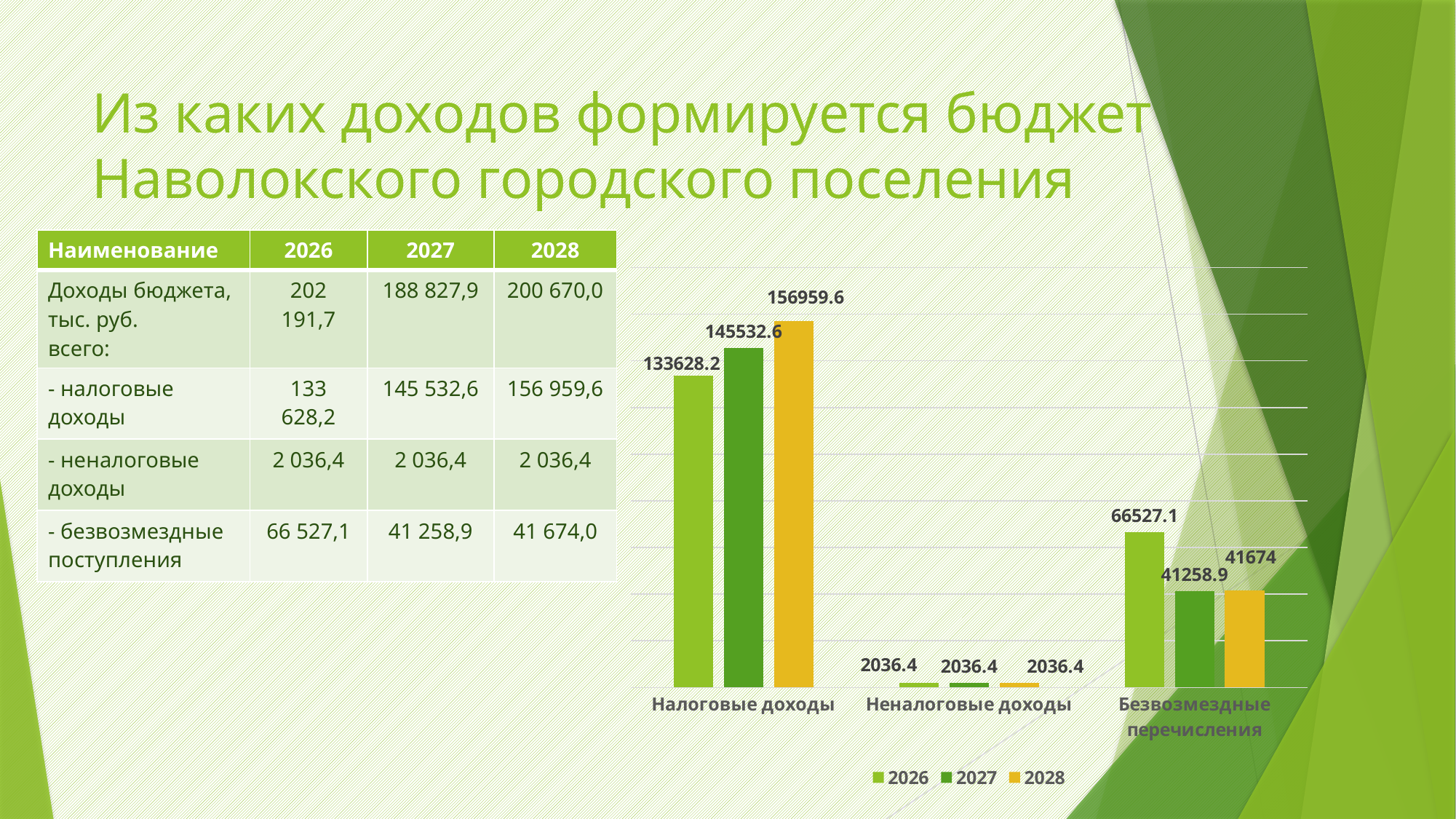
What type of chart is shown on the slide? bar chart What is the value for Налоговые доходы in 2026 on the chart? 133628.2 Which year has the highest value for Налоговые доходы on the chart? 2028 How many series does the chart legend list? 3 Which is larger on the chart: Безвозмездные перечисления in 2026 or in 2027? 2026 Which category has the lowest values on the chart? Неналоговые доходы Do the values for Налоговые доходы rise or fall from 2026 to 2028 on the chart? rise What is the value for Неналоговые доходы in 2028 on the chart? 2036.4 What is the value for Налоговые доходы in 2028 on the chart? 156959.6 How many categories are shown on the x axis of the chart? 3 What is the difference between the 2028 and 2026 values for Налоговые доходы on the chart? 23331.4 What is the value for Безвозмездные перечисления in 2027 on the chart? 41258.9